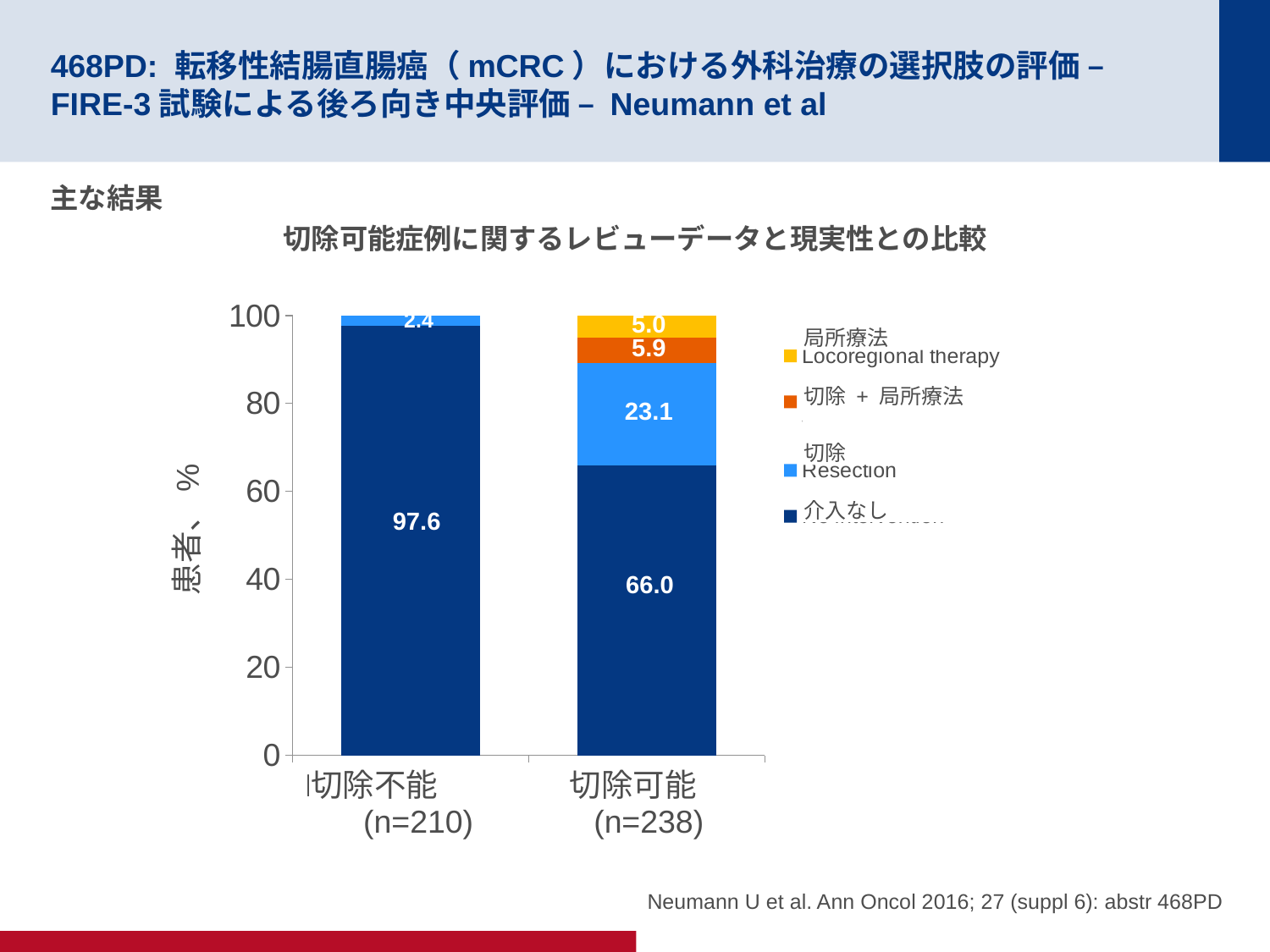
How many categories are shown on the x axis? 2 What is the value for 切除 (Resection) in the 切除不能 (n=210) bar? 2.4 What is the value for 切除 + 局所療法 in the 切除可能 (n=238) bar? 5.9 Which bar has the larger 切除 (Resection) value, 切除不能 (n=210) or 切除可能 (n=238)? 切除可能 (n=238) Which segment is the smallest in the 切除可能 (n=238) bar? 局所療法 (Locoregional therapy) What is the difference between the 介入なし values for 切除不能 (n=210) and 切除可能 (n=238)? 31.6 What is the value for 局所療法 (Locoregional therapy) in the 切除可能 (n=238) bar? 5.0 What is the value for 切除 (Resection) in the 切除可能 (n=238) bar? 23.1 What kind of chart is shown on the slide? Stacked bar chart What is the value for 介入なし in the 切除不能 (n=210) bar? 97.6 How many series does the legend list? 4 Which segment is the largest in the 切除可能 (n=238) bar? 介入なし